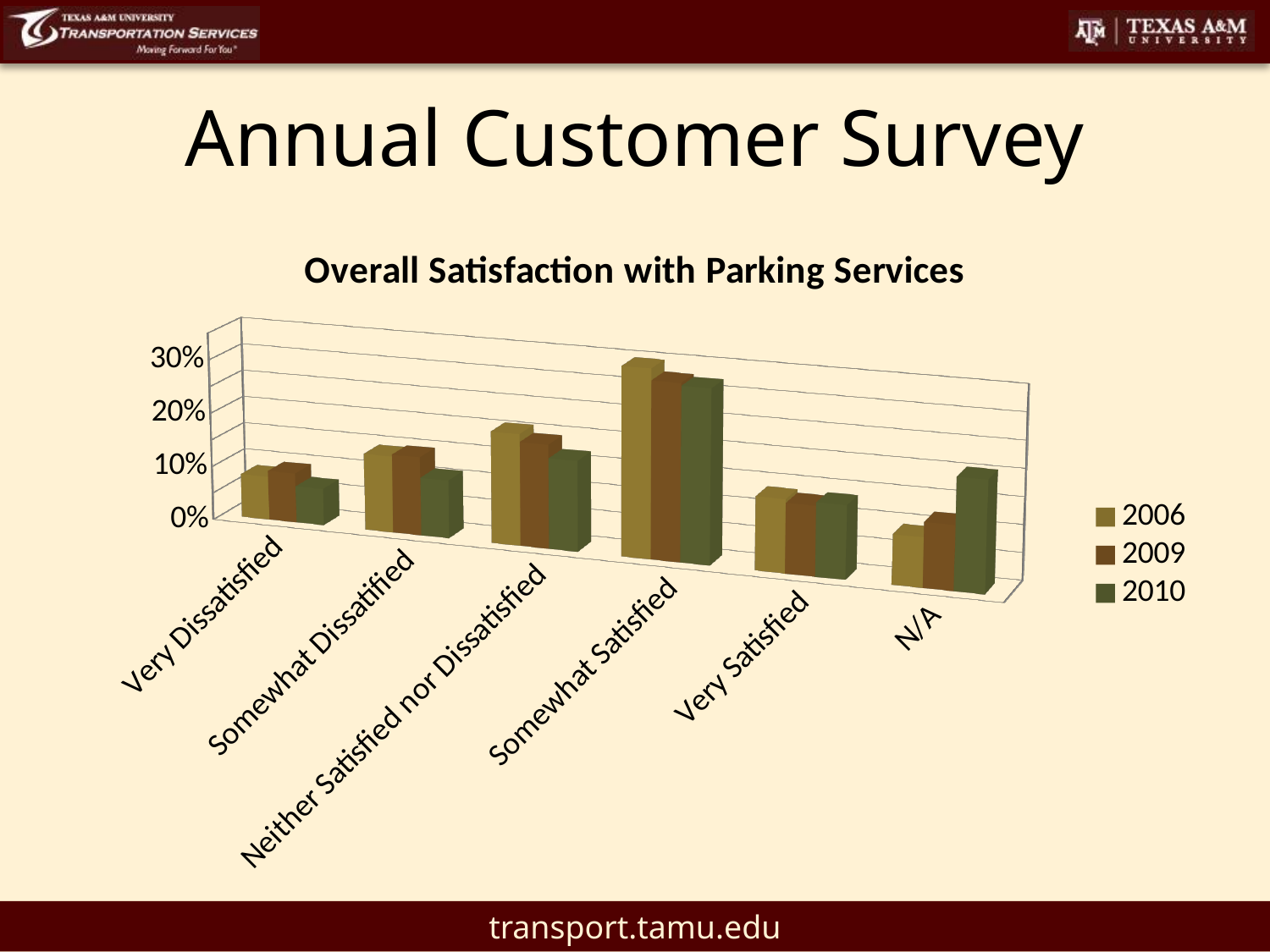
Which years are listed in the chart's legend? 2006, 2009, 2010 Which category has the lowest value for 2006? Very Dissatisfied For the N/A category, which year has the larger value, 2006 or 2010? 2010 What kind of chart is shown on the slide? Bar chart Which category has the highest value for 2006? Somewhat Satisfied Is the 2006 value for Somewhat Satisfied greater or less than 20%? greater Which category has the highest value for 2010? Somewhat Satisfied What is the title of the chart? Overall Satisfaction with Parking Services How many series does the legend list? 3 How many response categories are shown on the x axis? 6 For Neither Satisfied nor Dissatisfied, which year has the larger value, 2006 or 2010? 2006